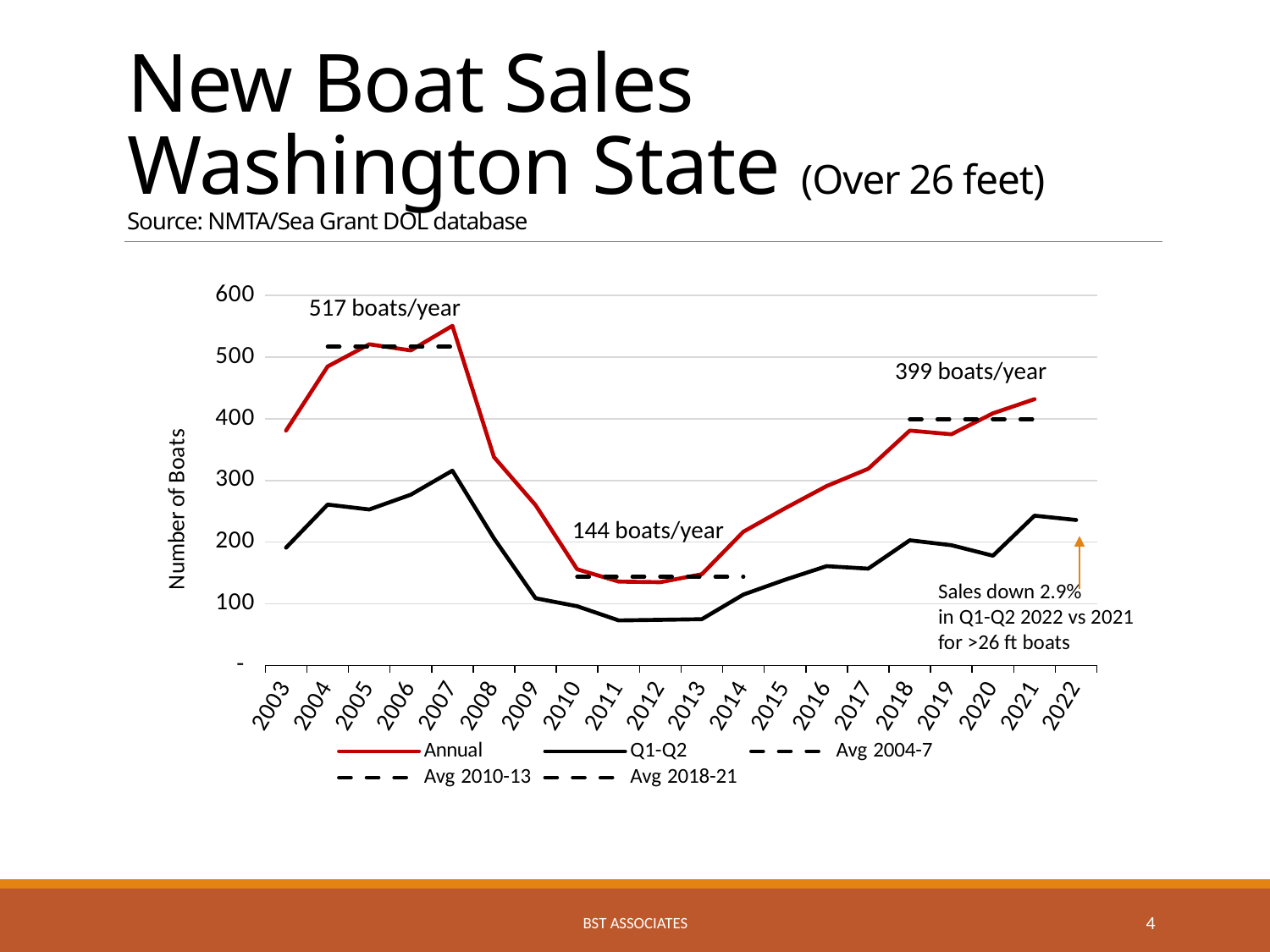
What is the average annual number of boats sold for 2018-21, as labelled on the chart? 399 boats/year How many entries does the chart legend list? 5 Does the Annual series rise or fall between 2007 and 2011? fall In which year does the Annual series reach its highest value? 2007 What kind of chart is shown on the slide? line chart What is the average annual number of boats sold for 2010-13, as labelled on the chart? 144 boats/year Is the Annual value for 2007 greater or less than 500? greater By how much does the 2004-7 average (517 boats/year) exceed the 2010-13 average (144 boats/year)? 373 boats/year Is the Annual value for 2011 greater or less than 200? less Which is larger, the Annual value for 2007 or the Annual value for 2021? 2007 What is the average annual number of boats sold for 2004-7, as labelled on the chart? 517 boats/year Is the Q1-Q2 value for 2021 greater or less than 200? greater